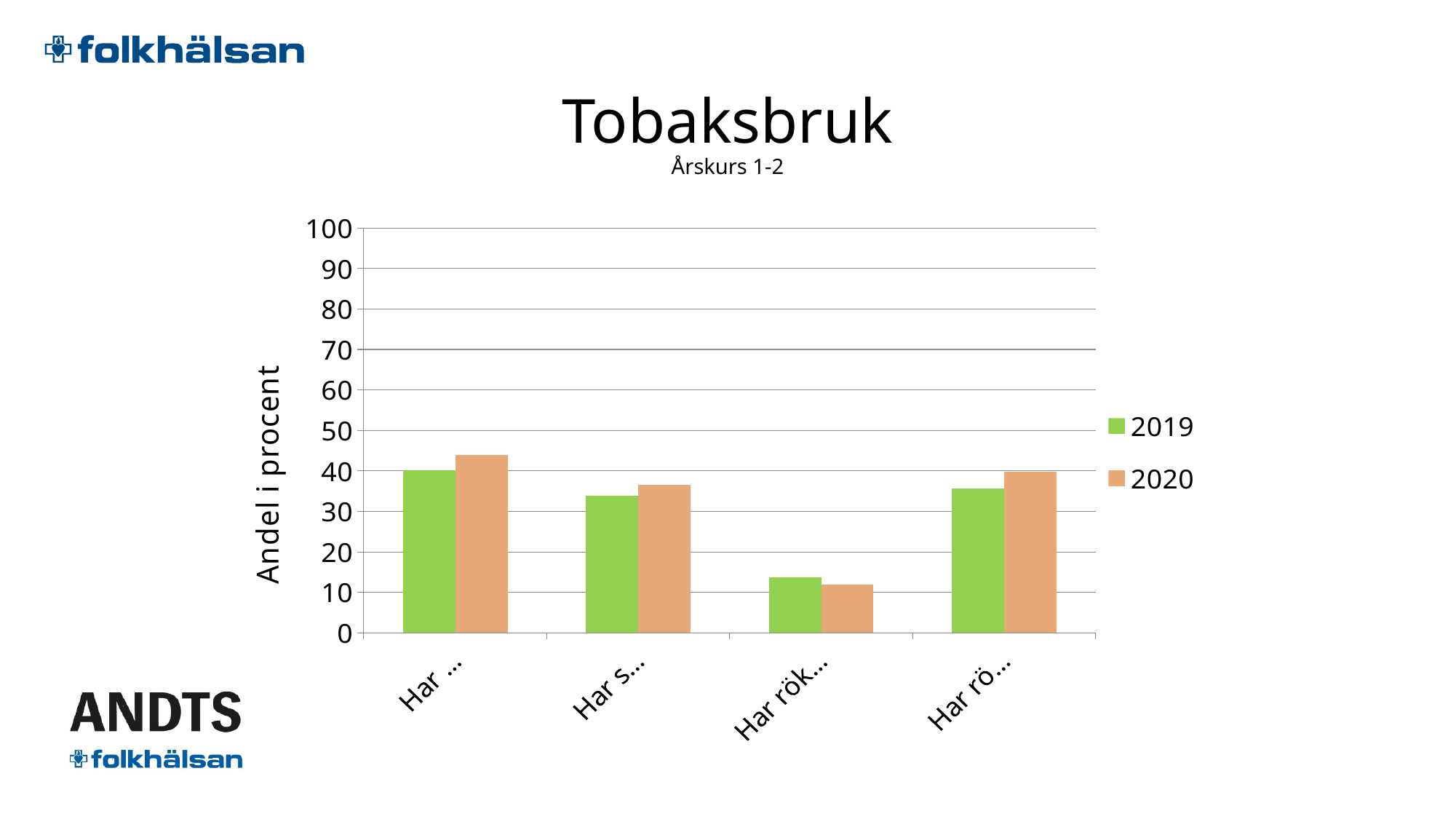
Which category group has the lowest values for both series? the third group In the fourth category group, which series has the larger value, 2019 or 2020? 2020 What is the title of the vertical axis? Andel i procent How many category groups are plotted along the x axis? 4 Is the 2020 value for the fourth category group greater or less than 50? less Is the 2019 value for the second category group greater or less than 30? greater What are the two series named in the legend? 2019 and 2020 Is the 2019 value for the third category group greater or less than 20? less How many series does the legend list? 2 What kind of chart is shown on the slide? bar chart In the first category group, which series has the larger value, 2019 or 2020? 2020